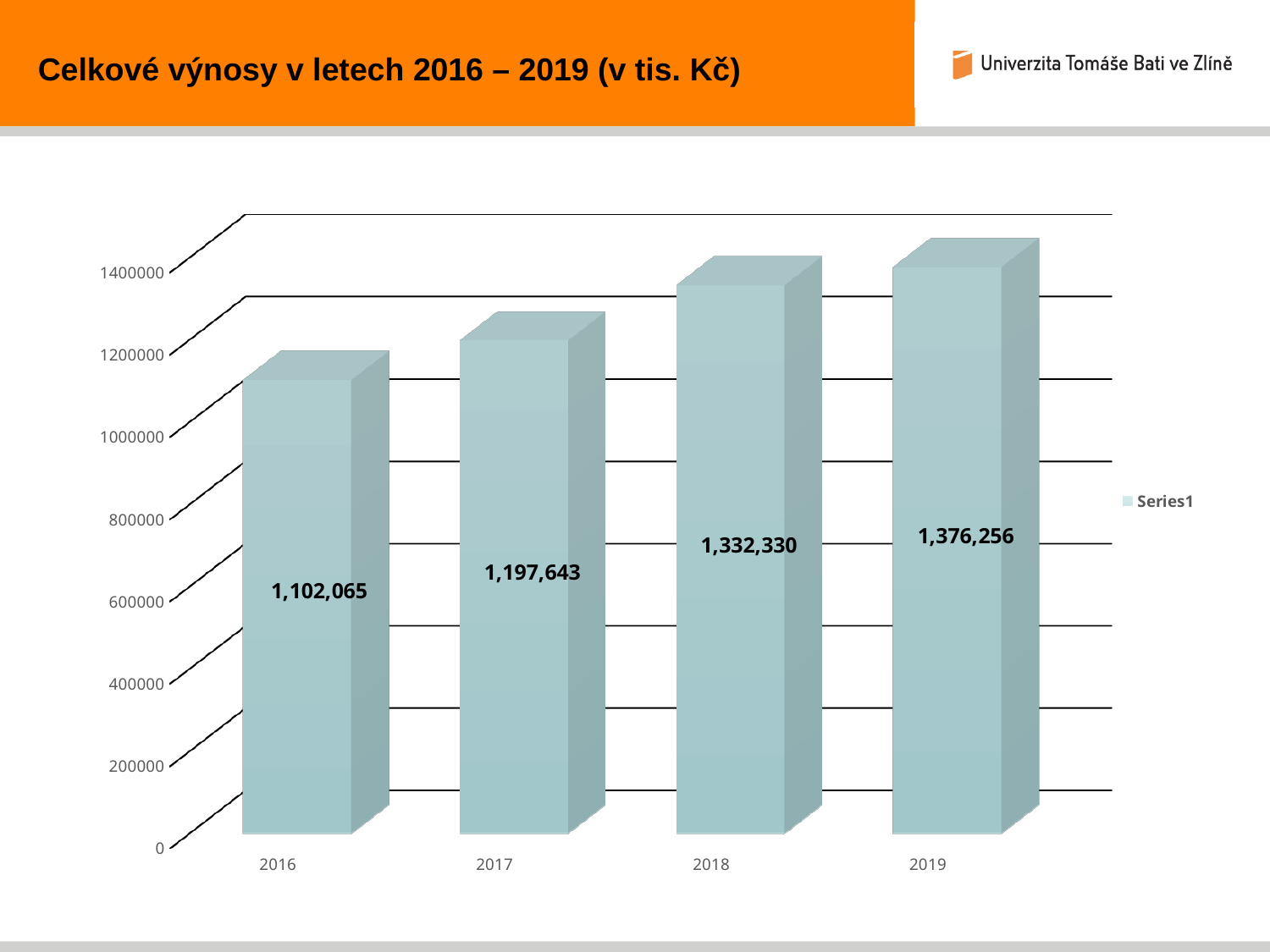
How many years are shown on the x axis? 4 What is the difference between the values for 2019 and 2018? 43,926 What is the value shown for 2018? 1,332,330 Which year has the lowest value? 2016 Which is larger, the value for 2017 or the value for 2018? 2018 What kind of chart is shown on the slide? Bar chart Do the values rise or fall from 2016 to 2019? Rise What is the value shown for 2017? 1,197,643 Which year has the highest value? 2019 What is the value shown for 2019? 1,376,256 What is the difference between the values for 2017 and 2016? 95,578 What is the value shown for 2016? 1,102,065